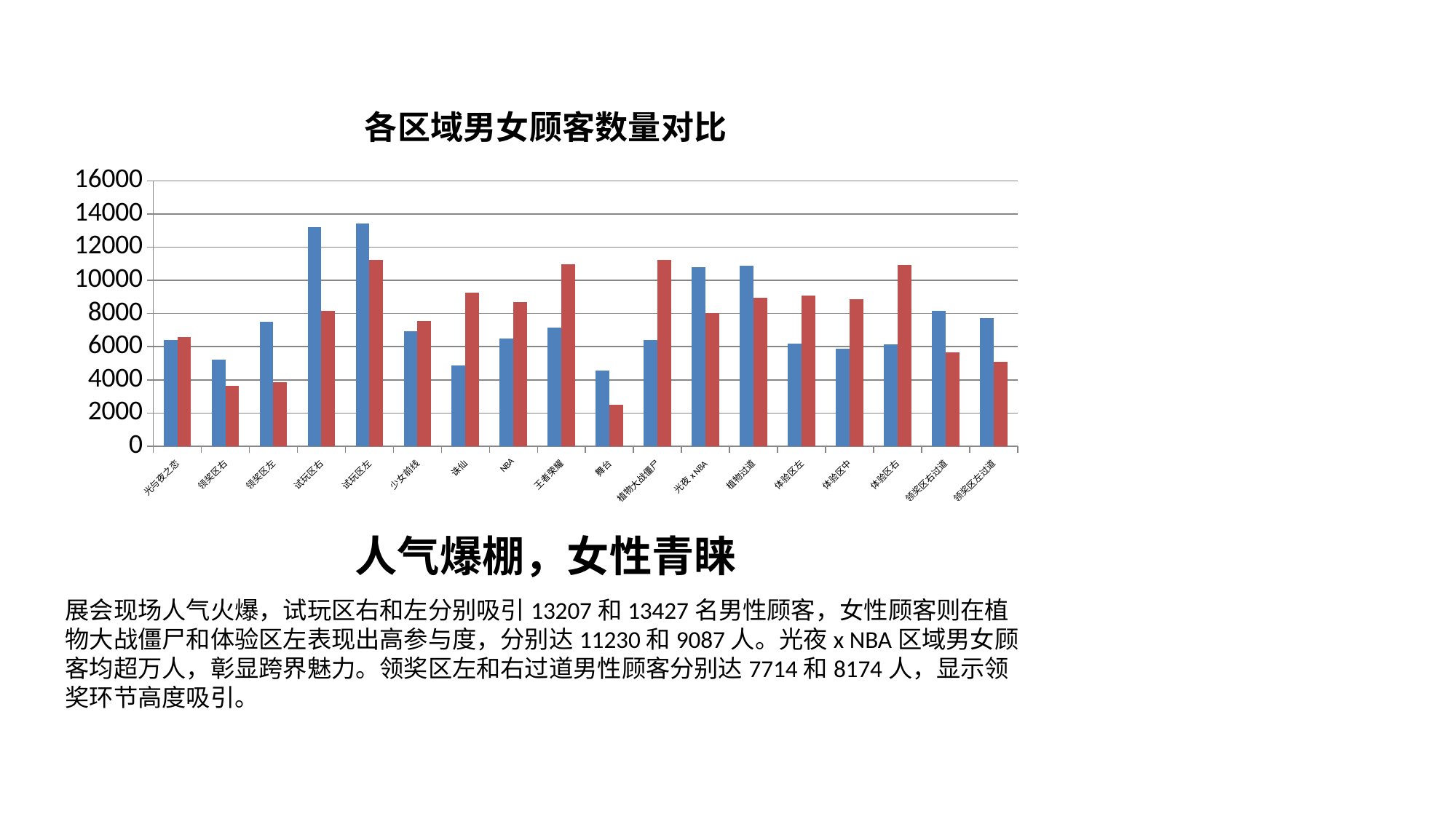
What two colours are used for the bars in the chart? blue and red Which category has the lowest red bar? 舞台 Is the red bar for 植物大战僵尸 greater or less than 10000? greater Is the blue bar for 试玩区右 greater or less than 12000? greater Is the blue bar for 光夜 x NBA greater or less than 10000? greater For 王者荣耀, which bar is taller, the blue one or the red one? the red one For 领奖区右, which bar is taller, the blue one or the red one? the blue one What is the title of the chart? 各区域男女顾客数量对比 How many categories are shown on the x axis of the chart? 18 What kind of chart is shown on the slide? bar chart